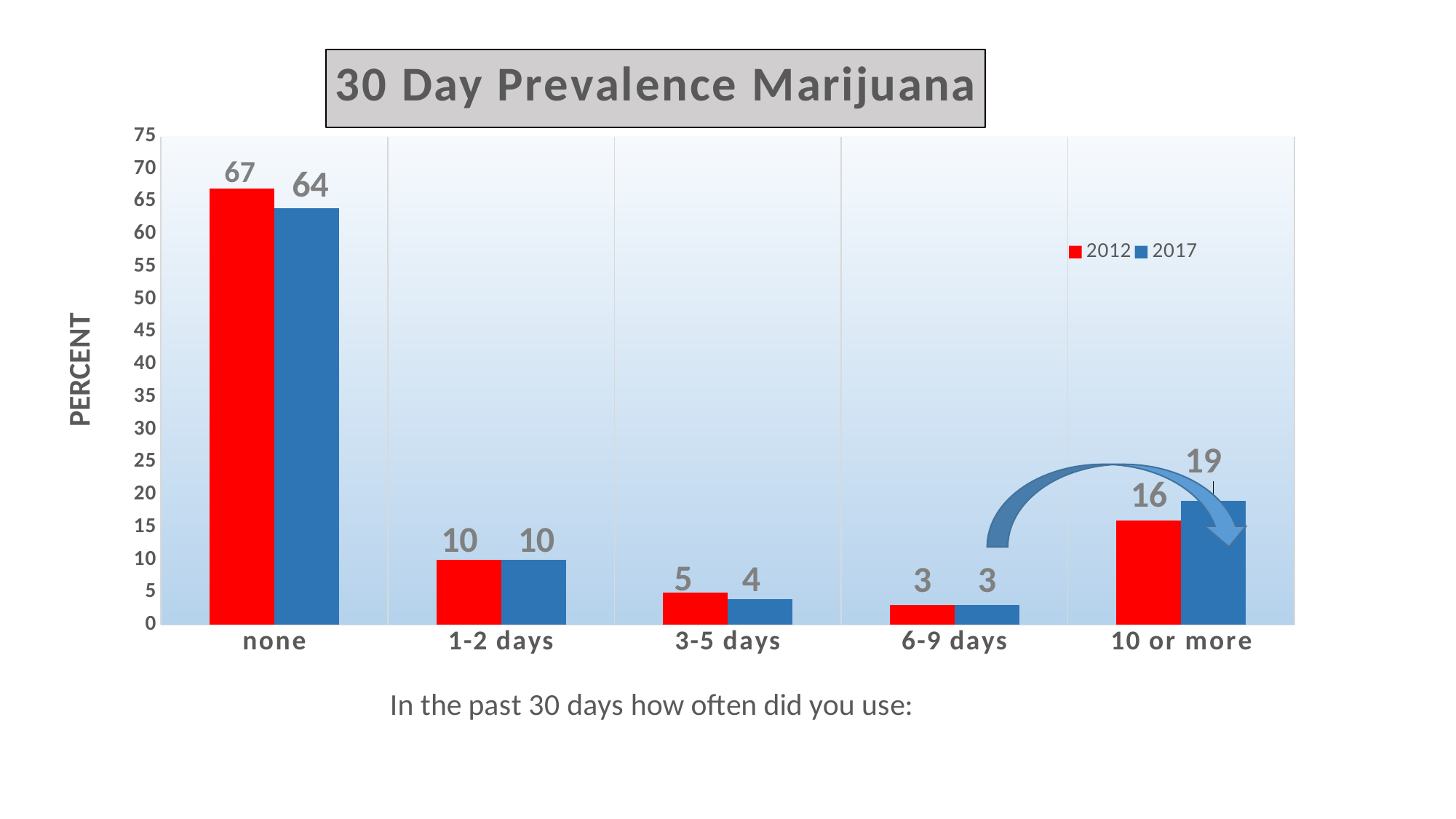
Which category has the lowest 2012 value? 6-9 days What is the difference between the 2012 and 2017 values for "none"? 3 What is the title of the chart? 30 Day Prevalence Marijuana What is the difference between the 2017 and 2012 values for "10 or more"? 3 How many series does the legend list? 2 For "10 or more", which year has the larger value, 2012 or 2017? 2017 What is the 2017 value for the "3-5 days" category? 4 What kind of chart is shown on the slide? bar chart Which category has the highest 2017 value? none What is the 2012 value for the "none" category? 67 What is the 2017 value for the "10 or more" category? 19 How many categories are shown on the x axis? 5